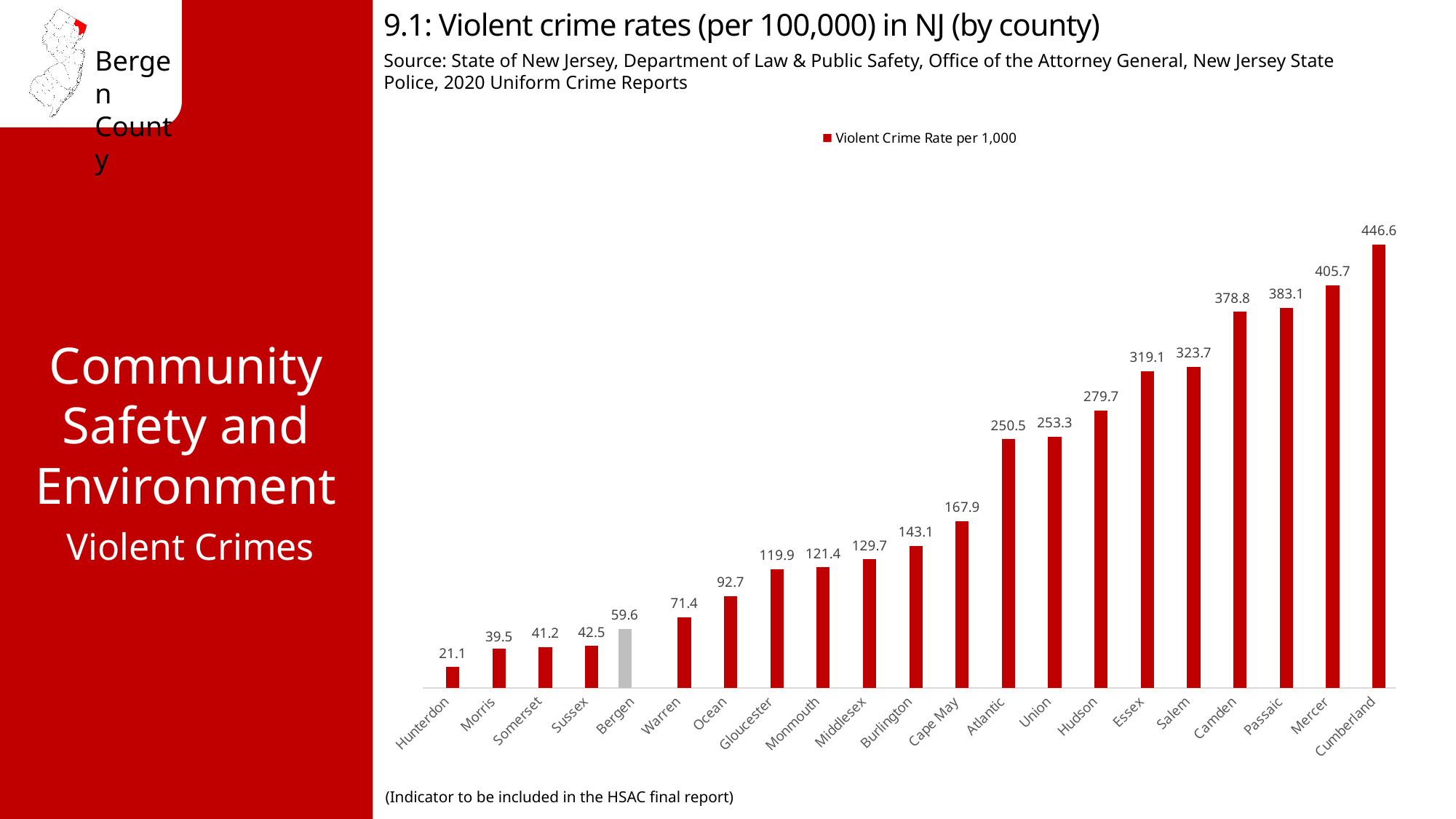
What is the violent crime rate for Bergen? 59.6 What is the difference between the violent crime rates of Mercer and Bergen? 346.1 How many counties are shown in the chart? 21 What is the difference between the violent crime rates of Cumberland and Hunterdon? 425.5 How many series does the legend list? 1 Which county has the highest violent crime rate? Cumberland What is the violent crime rate for Cape May? 167.9 What kind of chart is shown on the slide? Bar chart Which county has a higher violent crime rate, Essex or Camden? Camden What is the violent crime rate for Hudson? 279.7 Which county has the lowest violent crime rate? Hunterdon Do the values rise or fall from left to right along the x axis? Rise